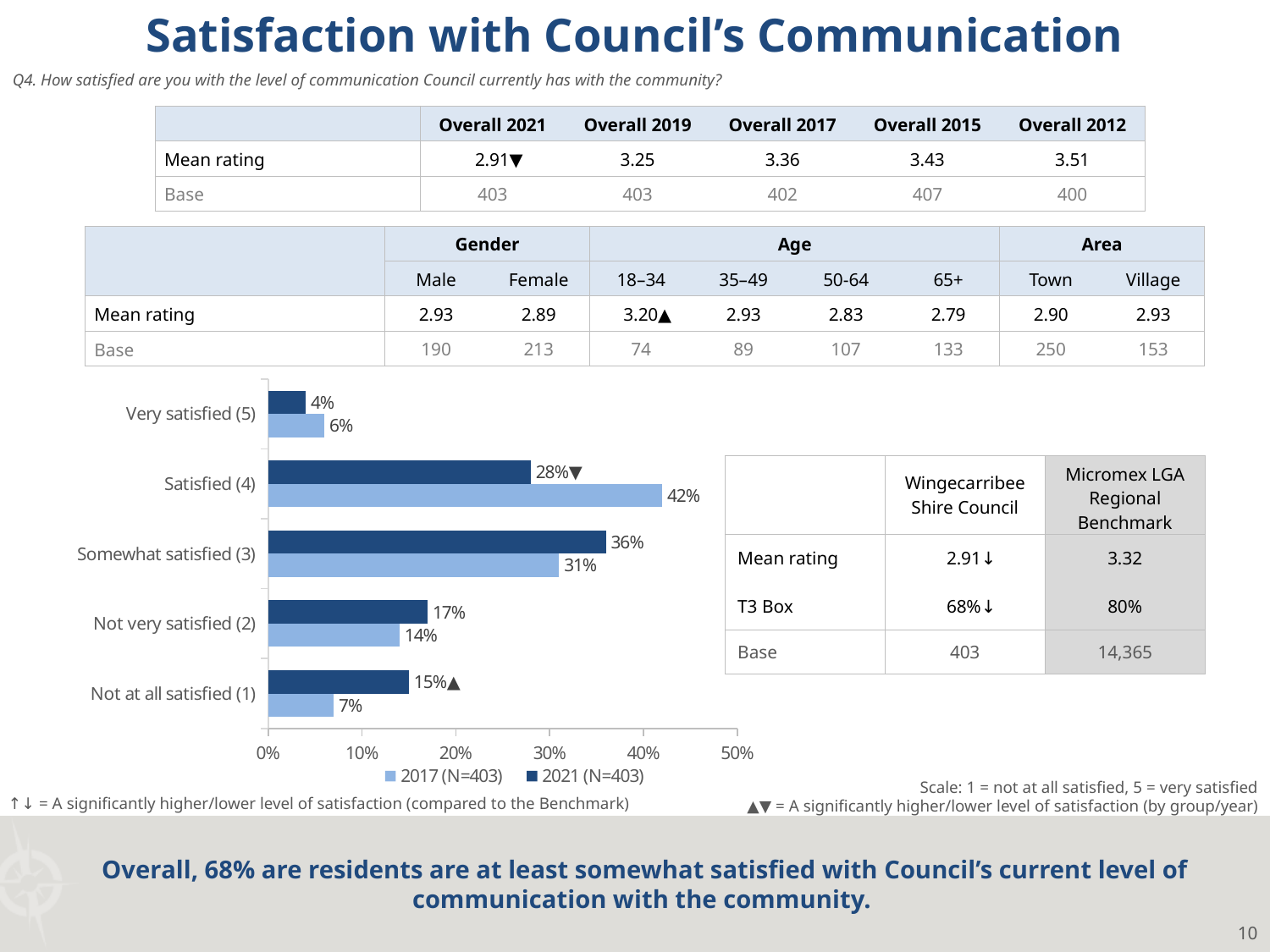
What is the 2017 value for Very satisfied (5)? 6% What are the two series named in the chart legend? 2017 (N=403) and 2021 (N=403) What kind of chart is shown on the slide? Bar chart How many categories are shown on the bar chart? 5 What is the difference between the 2017 and 2021 values for Satisfied (4)? 14% Which category has the lowest 2017 value? Very satisfied (5) Which is larger for Not at all satisfied (1): the 2017 value or the 2021 value? 2021 Which category has the highest 2021 value? Somewhat satisfied (3) What is the 2017 value for Satisfied (4)? 42% How many series does the chart legend list? 2 What is the 2021 value for Not at all satisfied (1)? 15% What is the 2021 value for Satisfied (4)? 28%